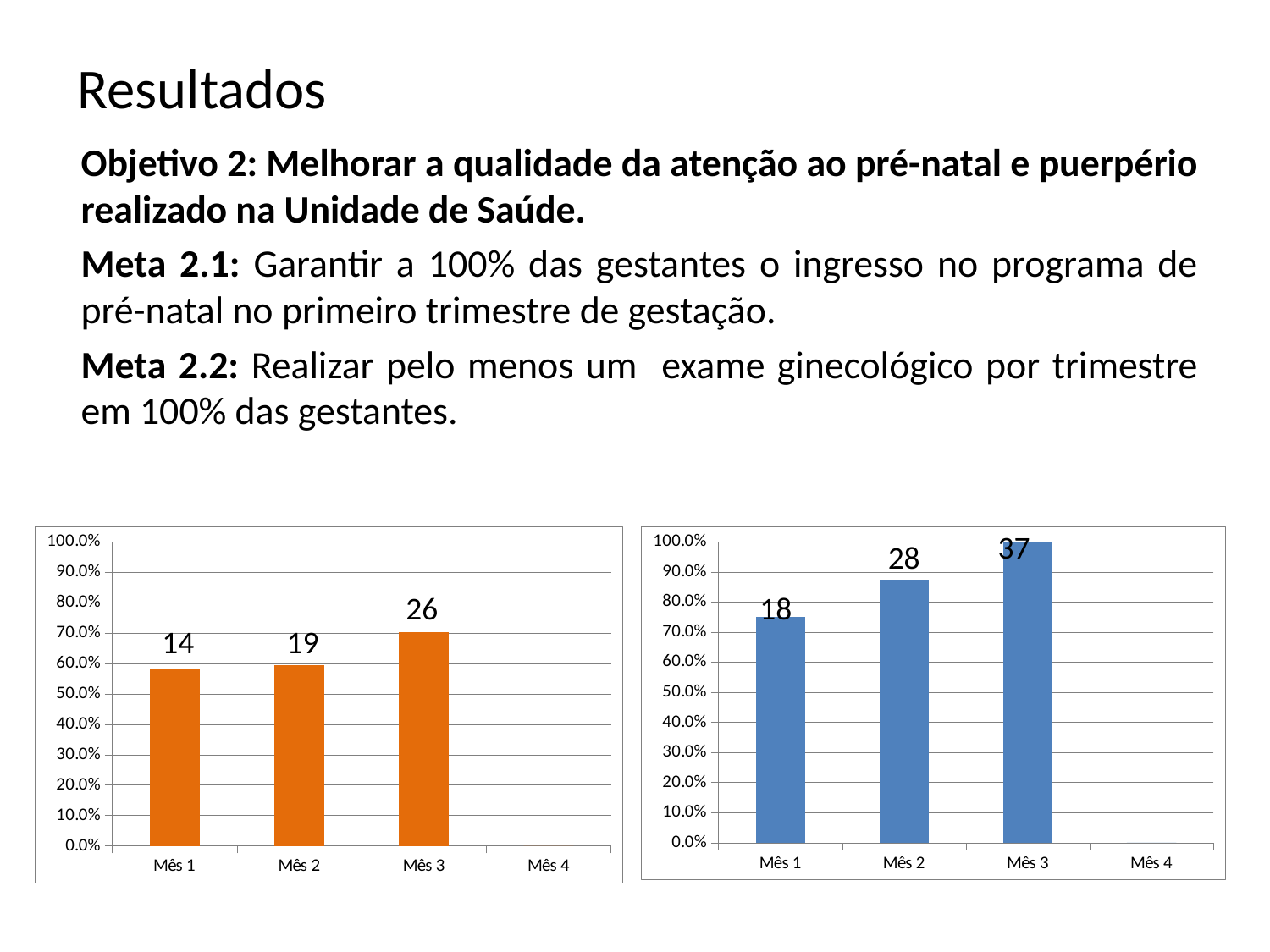
In the left chart (orange bars), what data label is shown on the bar for Mês 1? 14 In the left chart (orange bars), is the value for Mês 2 greater or less than 70.0%? less In the right chart (blue bars), what is the difference between the data labels for Mês 3 and Mês 1? 19 In the right chart (blue bars), is the value for Mês 1 greater or less than 70.0%? greater In the right chart (blue bars), what data label is shown on the bar for Mês 3? 37 In the right chart (blue bars), what data label is shown on the bar for Mês 2? 28 In the right chart (blue bars), do the bar values rise or fall from Mês 1 to Mês 3? Rise What type of chart is the left chart? Bar chart In the left chart (orange bars), which month has the highest bar? Mês 3 In the left chart (orange bars), what data label is shown on the bar for Mês 3? 26 In the right chart (blue bars), which month has the highest bar? Mês 3 In the left chart (orange bars), what is the difference between the data labels for Mês 3 and Mês 1? 12